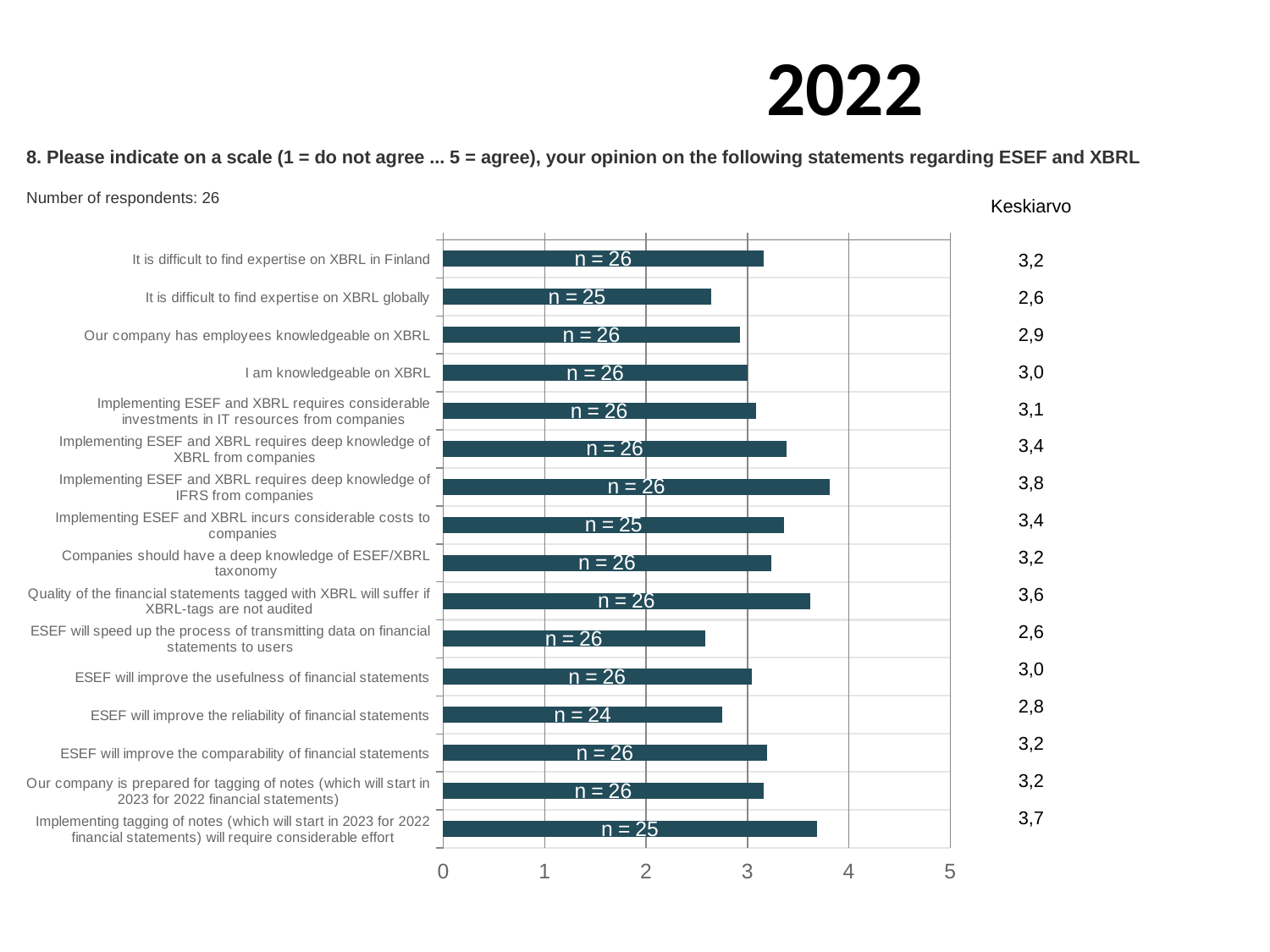
How many statements (categories) are plotted in the chart? 16 What is the mean (Keskiarvo) value for 'Implementing ESEF and XBRL requires deep knowledge of IFRS from companies'? 3,8 What is the difference between the mean for 'Implementing ESEF and XBRL requires deep knowledge of IFRS from companies' and the mean for 'It is difficult to find expertise on XBRL globally'? 1,2 Is the value for 'Implementing tagging of notes (which will start in 2023 for 2022 financial statements) will require considerable effort' greater or less than 3? greater Which statement has the highest mean value? Implementing ESEF and XBRL requires deep knowledge of IFRS from companies What is the mean (Keskiarvo) value for 'ESEF will improve the reliability of financial statements'? 2,8 Is the value for 'ESEF will speed up the process of transmitting data on financial statements to users' greater or less than 3? less What is the heading of the column of values shown to the right of the chart? Keskiarvo What is the number of respondents (n) shown on the bar for 'ESEF will improve the reliability of financial statements'? n = 24 What is the mean (Keskiarvo) value for 'Quality of the financial statements tagged with XBRL will suffer if XBRL-tags are not audited'? 3,6 What kind of chart is shown on the slide? bar chart Which has a higher mean value: 'It is difficult to find expertise on XBRL in Finland' or 'It is difficult to find expertise on XBRL globally'? It is difficult to find expertise on XBRL in Finland